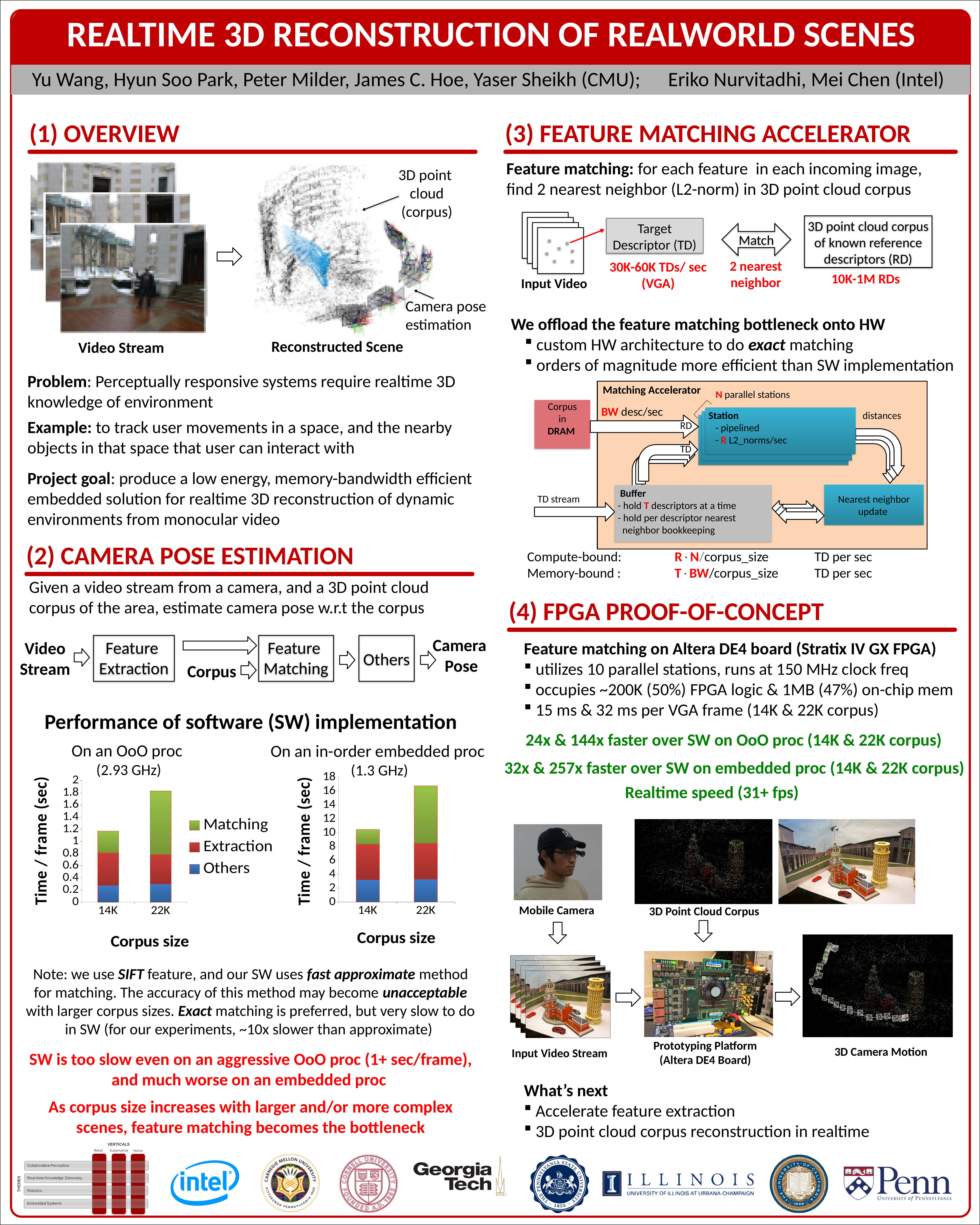
In the 'On an in-order embedded proc (1.3 GHz)' chart, is the total time per frame for 14K greater or less than 12 sec? less What is the y-axis label of the 'On an in-order embedded proc (1.3 GHz)' chart? Time / frame (sec) How many corpus sizes are shown on the x axis of the 'On an in-order embedded proc (1.3 GHz)' chart? 2 In the 'On an OoO proc (2.93 GHz)' chart, is the total time per frame for 14K greater or less than 1.4 sec? less In the 'On an in-order embedded proc (1.3 GHz)' chart, which corpus size has the lower total time per frame? 14K In the 'On an OoO proc (2.93 GHz)' chart, which corpus size has the taller total bar, 14K or 22K? 22K In the 'On an OoO proc (2.93 GHz)' chart, does the total time per frame rise or fall as corpus size increases from 14K to 22K? rise In the 'On an in-order embedded proc (1.3 GHz)' chart, is the total time per frame for 22K greater or less than 14 sec? greater What kind of chart is the 'On an OoO proc (2.93 GHz)' chart? stacked bar chart Which series is shown in green in the software performance charts? Matching How many series does the legend list for the software performance charts? 3